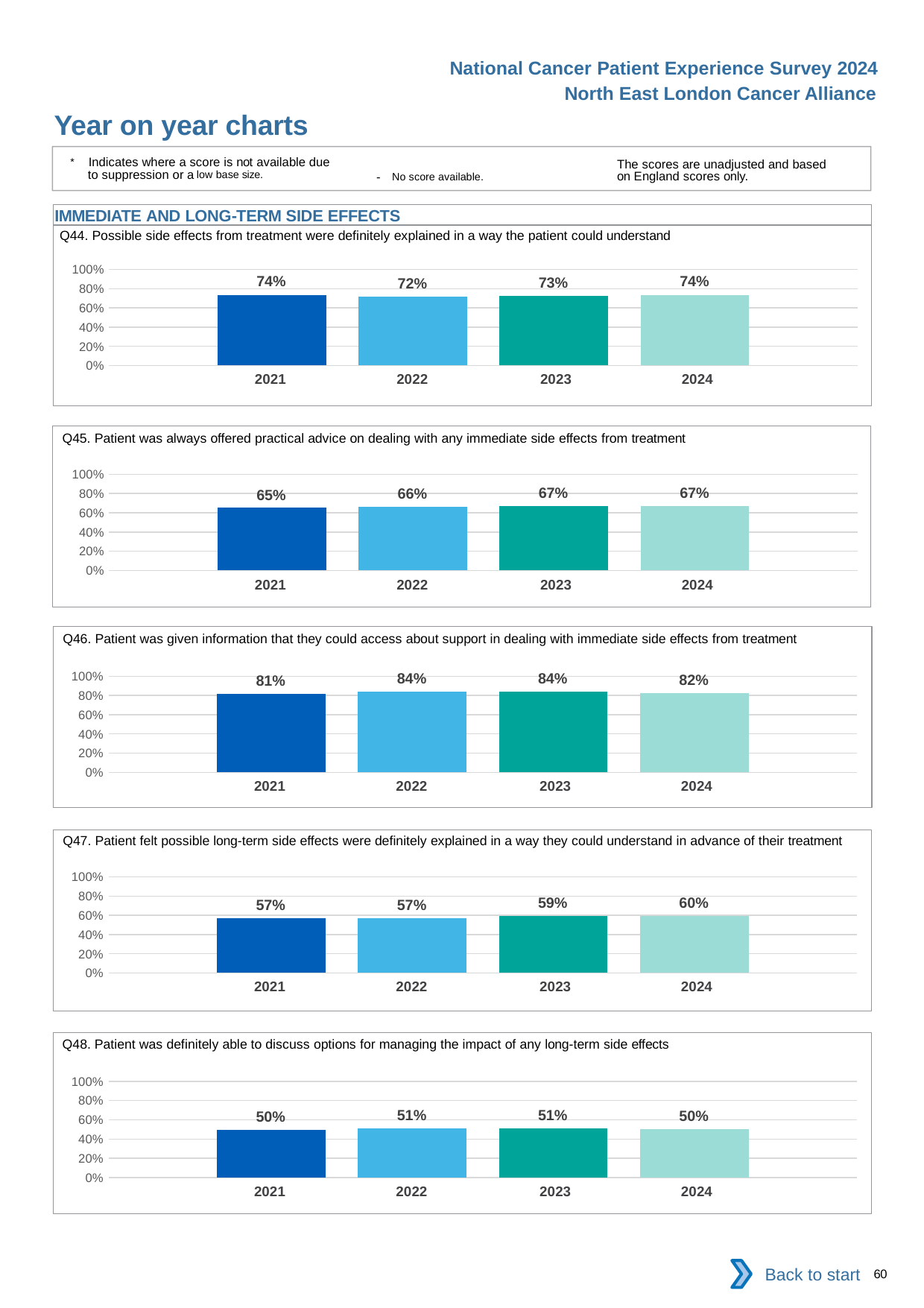
In the Q46 chart, what is the difference between the 2023 value and the 2021 value? 3% How many years are shown in the Q44 chart? 4 In the Q47 chart, do the values rise or fall from 2022 to 2024? rise In the Q44 chart, what is the value for 2022? 72% In the Q48 chart, is the value for 2023 greater or less than 60%? less How many charts are shown on the slide? 5 In the Q48 chart, what is the value for 2024? 50% What kind of chart is the Q46 chart? bar chart In the Q47 chart, which is larger, the value for 2024 or the value for 2021? 2024 In the Q45 chart, what is the difference between the 2024 value and the 2021 value? 2% In the Q46 chart, which year has the lowest value? 2021 In the Q45 chart, which year has the lowest value? 2021